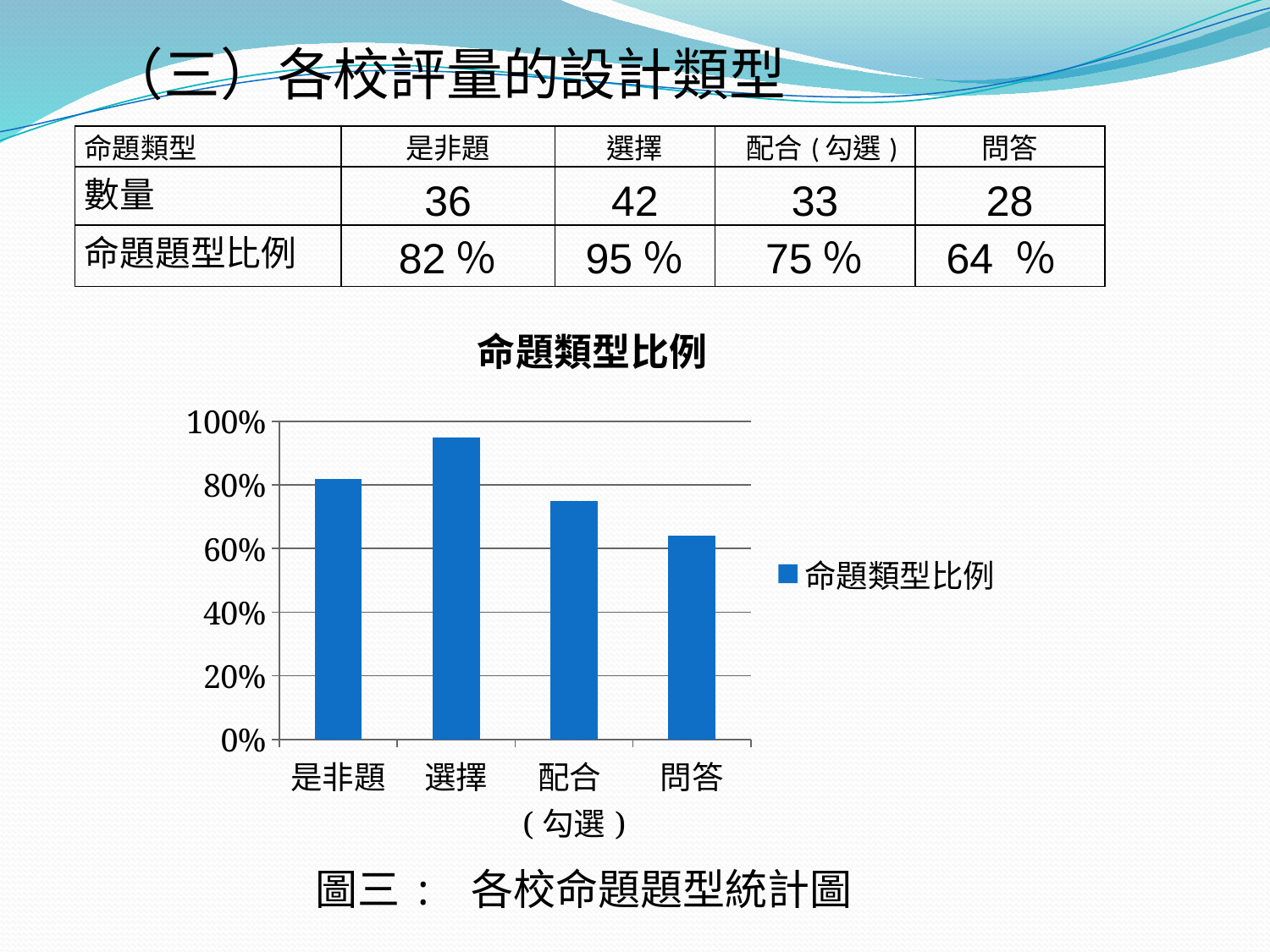
Is the value for 問答 greater or less than 80%? less How many categories are shown on the x axis of the chart? 4 What is the title of the chart? 命題類型比例 How many series does the chart legend list? 1 According to the table on the slide, what is the 命題題型比例 for 問答? 64 % Is the value for 配合（勾選） greater or less than 60%? greater According to the table on the slide, what is the 命題題型比例 for 選擇? 95 % What kind of chart is shown on the slide? bar chart Is the value for 選擇 greater or less than 80%? greater Which category has the lowest bar in the chart? 問答 Which is larger, the value for 是非題 or the value for 配合（勾選）? 是非題 Which category has the highest bar in the chart? 選擇